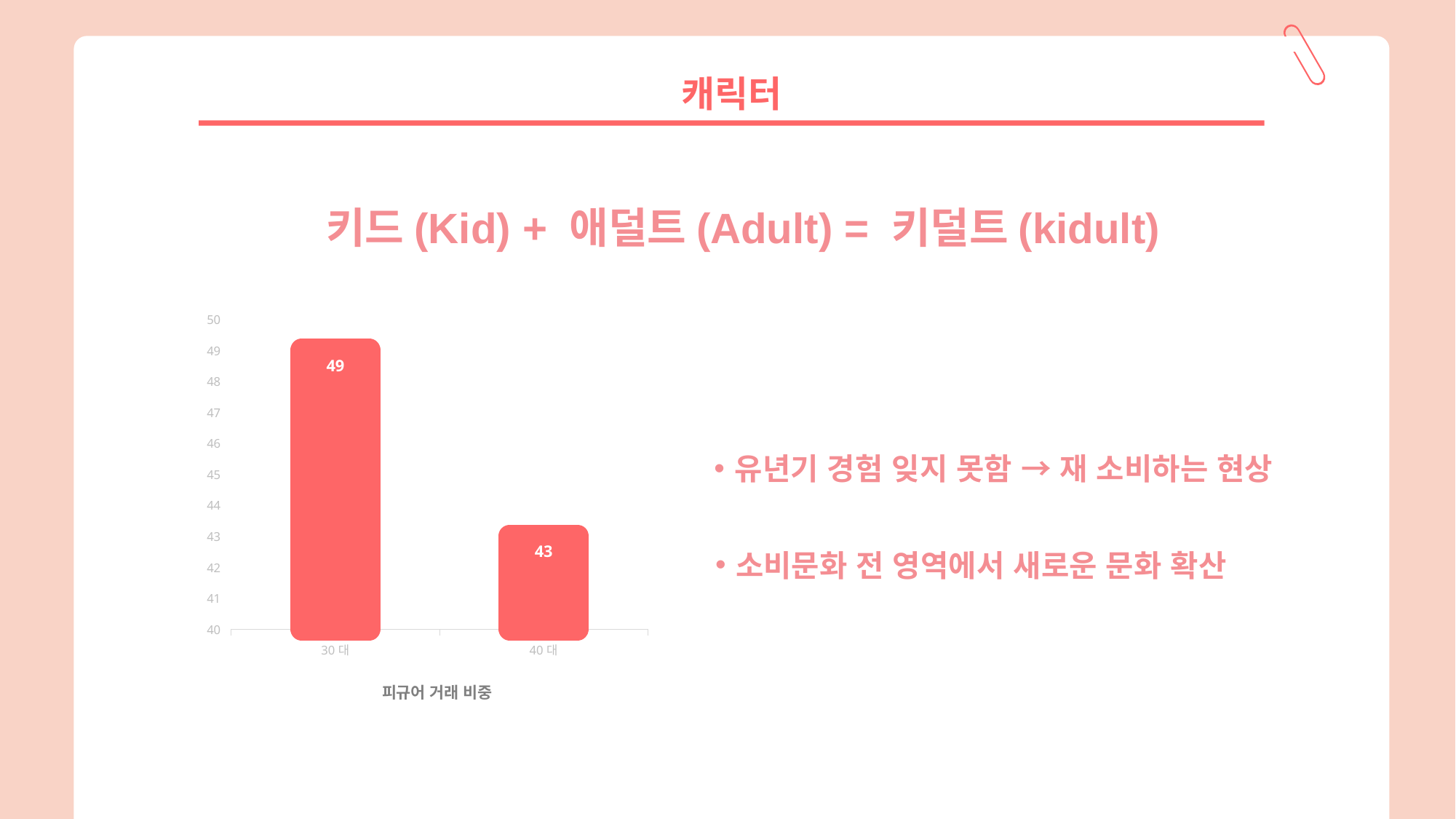
Do the values rise or fall from 30 대 to 40 대? fall How many categories are shown in the chart? 2 What is the value for 40 대 in the 피규어 거래 비중 chart? 43 Is the value for 40 대 greater or less than 45? less What is the value for 30 대 in the 피규어 거래 비중 chart? 49 What kind of chart is shown on the slide? bar chart Which is larger, the value for 30 대 or the value for 40 대? 30 대 What is the title of the chart? 피규어 거래 비중 Which category has the highest value in the chart? 30 대 What is the difference between the values for 30 대 and 40 대? 6 Which category has the lowest value in the chart? 40 대 Is the value for 30 대 greater or less than 45? greater